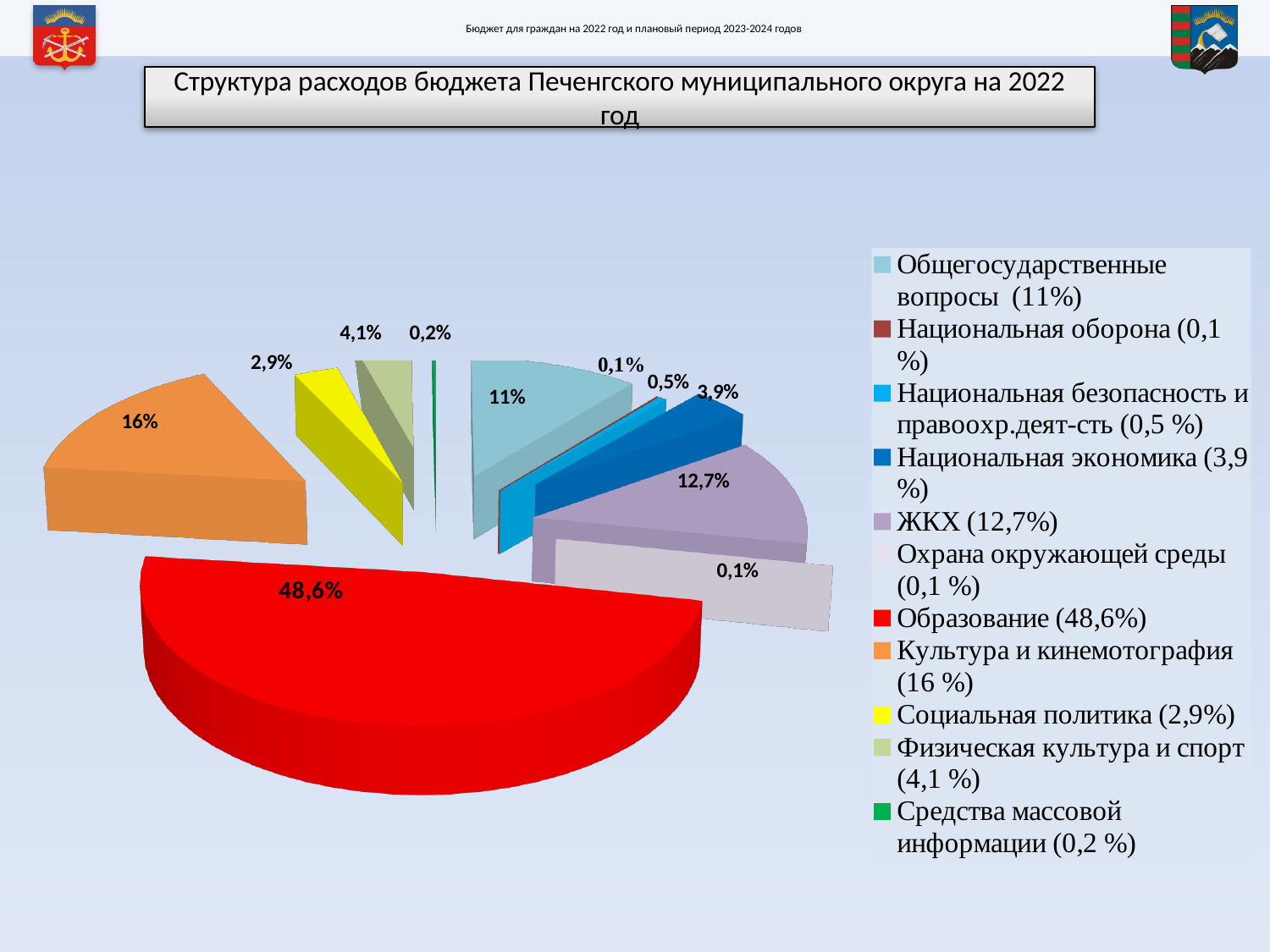
What kind of chart is shown on the slide? pie chart What percentage is shown for ЖКХ? 12,7% What percentage is shown for Культура и кинемотография? 16% What percentage is shown for Средства массовой информации? 0,2% What is the difference between the share for Физическая культура и спорт and the share for Социальная политика? 1,2% What percentage is shown for Физическая культура и спорт? 4,1% Which is larger: the share for ЖКХ or the share for Общегосударственные вопросы? ЖКХ What is the difference between the share for Образование and the share for Культура и кинемотография? 32,6% What colour is the slice for Образование? red What share of the budget expenditure goes to Образование? 48,6% How many categories does the legend of the pie chart list? 11 Which category has the largest share of the budget expenditure? Образование